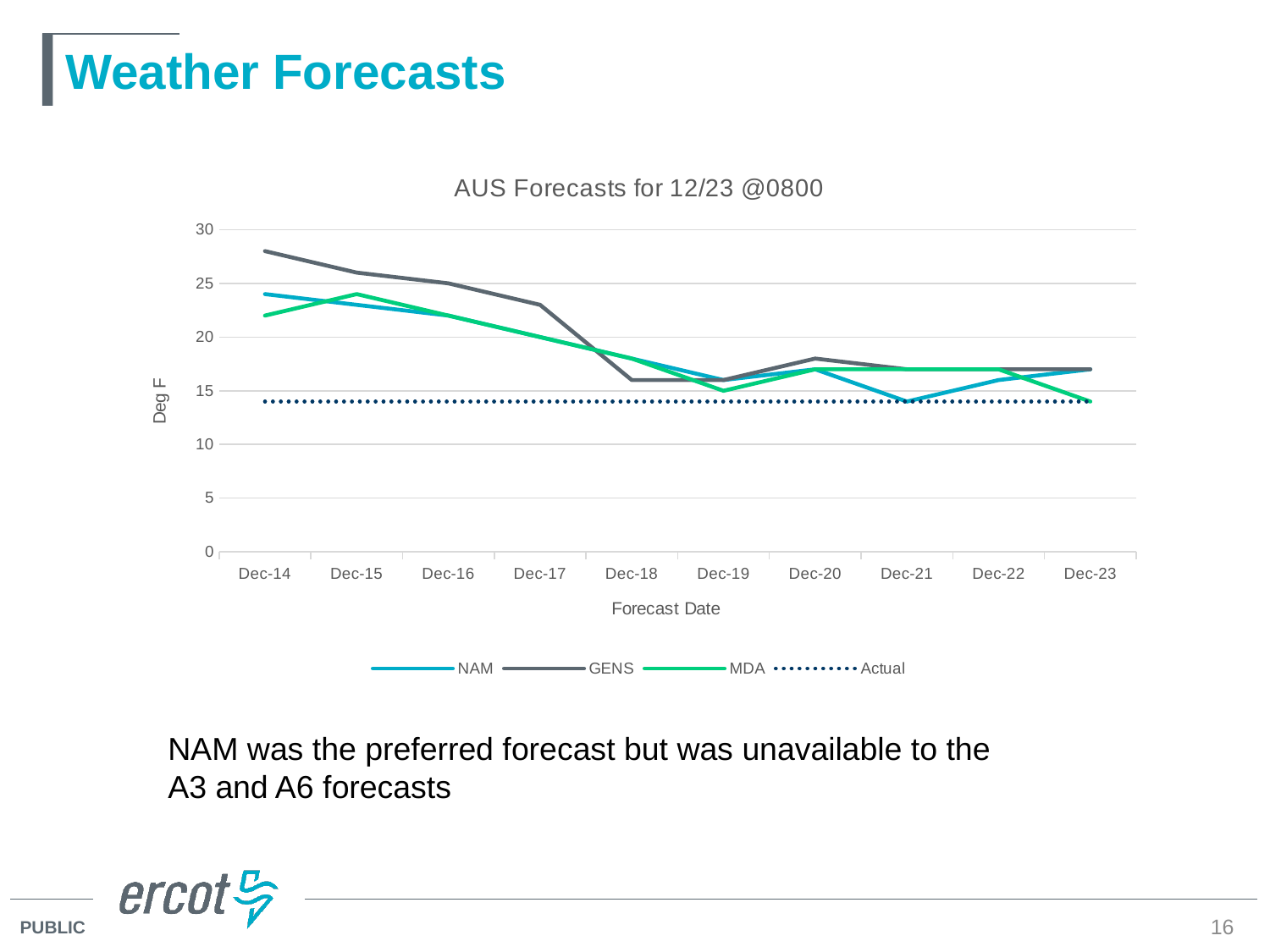
Is the Actual value greater or less than 15? less What is the title of the chart? AUS Forecasts for 12/23 @0800 Which series has the highest value at Dec-14? GENS Is the MDA value at Dec-14 greater or less than 20? greater Does the GENS series rise or fall from Dec-14 to Dec-18? fall What kind of chart is shown on the slide? line chart How many series does the legend list? 4 What is the label on the y axis? Deg F How many forecast dates are shown on the x axis? 10 Which series has the lowest value at Dec-14? Actual Is the GENS value at Dec-14 greater or less than 25? greater At Dec-17, which is larger, the GENS value or the MDA value? GENS